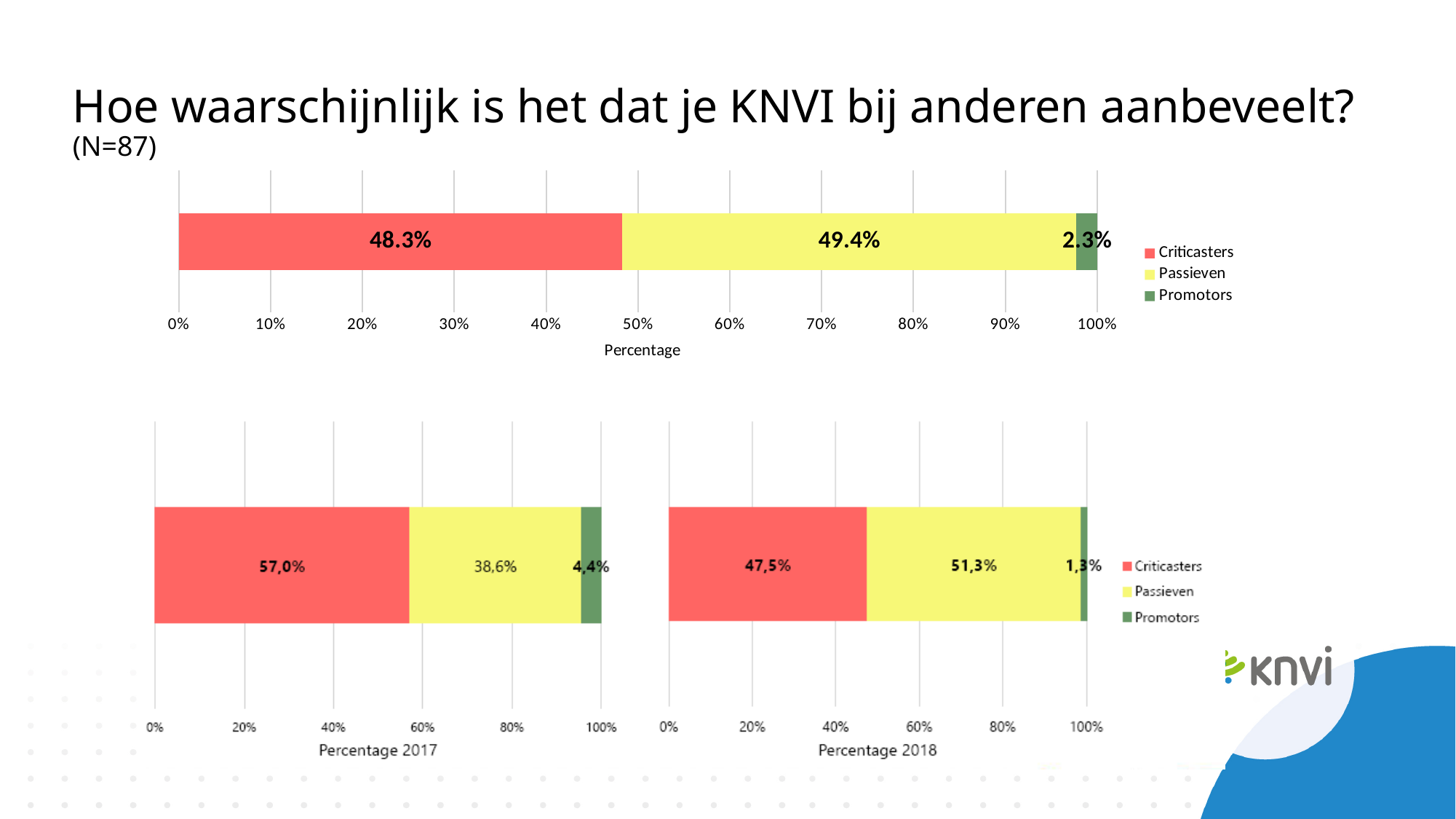
In the bottom-right chart (Percentage 2018), what is the value for Promotors? 1,3% In the bottom-right chart (Percentage 2018), what is the difference between Passieven and Criticasters? 3,8% In the bottom-left chart (Percentage 2017), what is the value for Passieven? 38,6% In the bottom-right chart (Percentage 2018), which is larger, Criticasters or Passieven? Passieven In the top chart (Percentage), what is the value for Passieven? 49.4% In the bottom-left chart (Percentage 2017), which segment is the largest? Criticasters In the top chart (Percentage), which segment is the smallest? Promotors What kind of chart is the bottom-left chart (Percentage 2017)? Stacked bar chart In the bottom-left chart (Percentage 2017), what is the value for Criticasters? 57,0% In the top chart (Percentage), what is the value for Criticasters? 48.3% In the top chart (Percentage), what is the value for Promotors? 2.3% How many series does the legend of the top chart list? 3